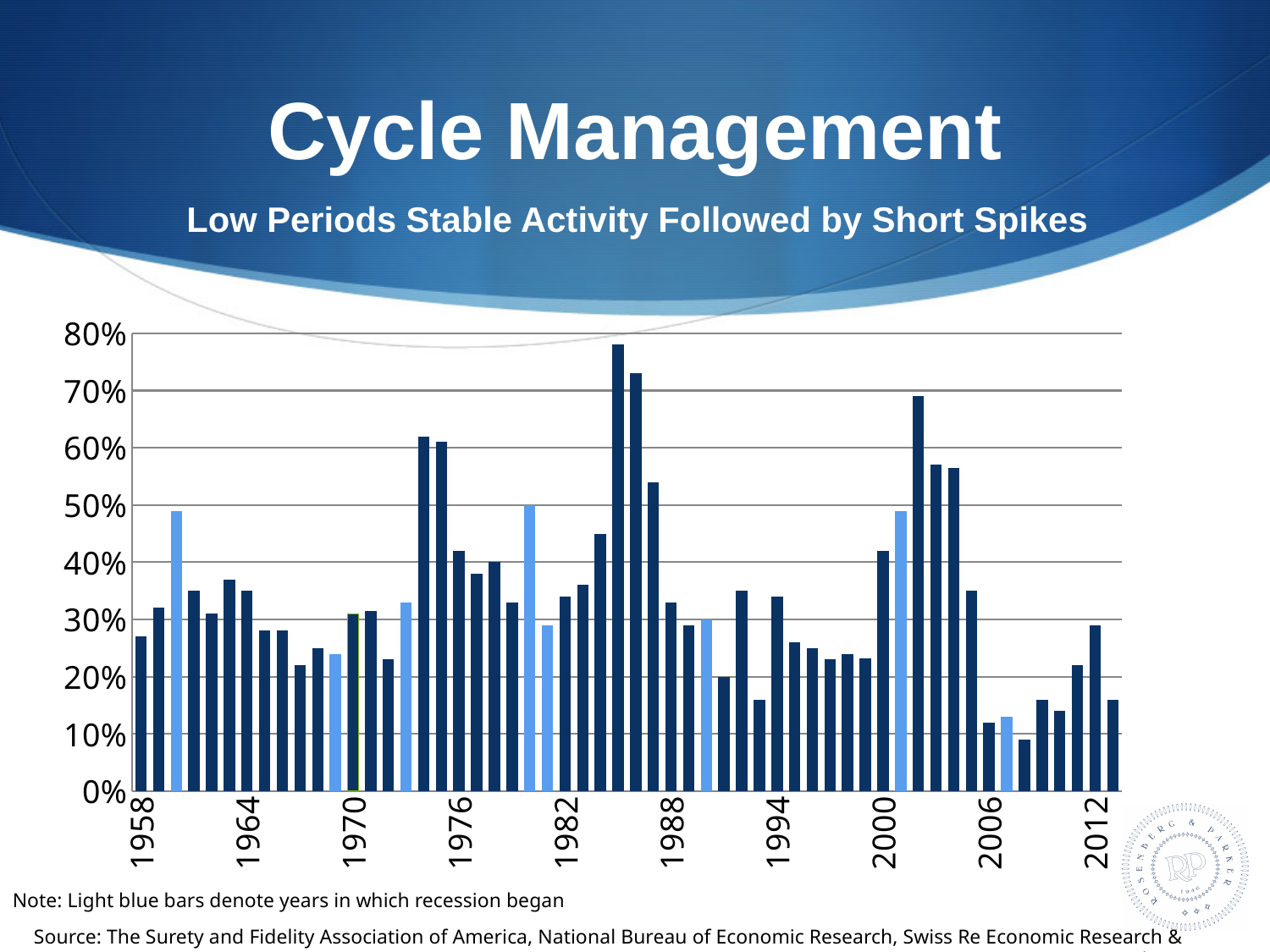
What kind of chart is shown on the slide? bar chart Do the values rise or fall from 2002 to 2008? fall Is the value for 1985 greater or less than 70%? greater Which is larger, the value for 2000 or the value for 2012? 2000 Is the value for 2000 greater or less than 40%? greater Is the value for 1976 greater or less than 40%? greater According to the note, what do the light blue bars denote? Years in which recession began Which year has the highest bar in the chart? 1985 What is the highest value shown on the vertical axis? 80% Which is larger, the value for 1958 or the value for 1964? 1964